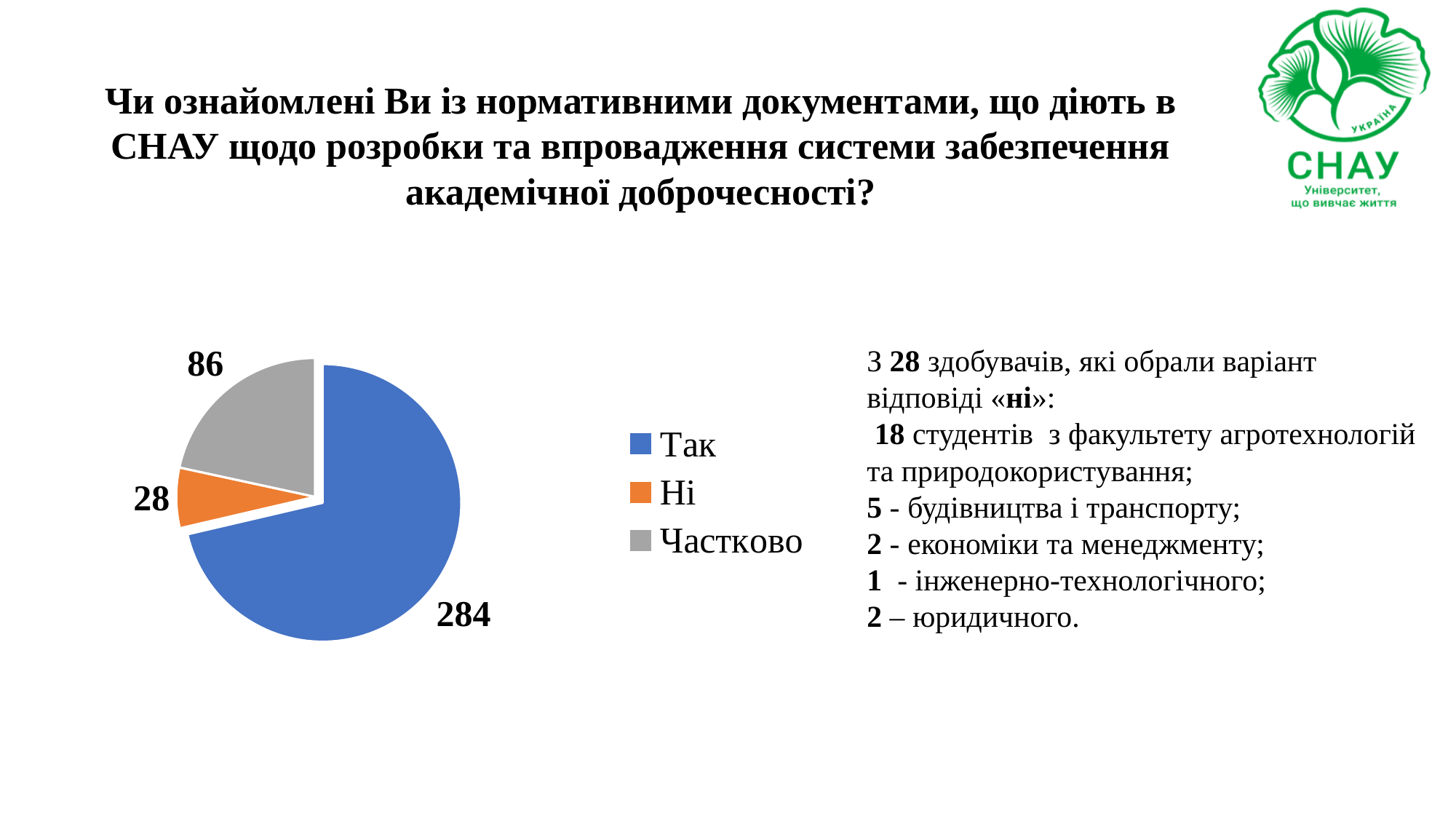
What value is shown for the "Частково" slice of the pie chart? 86 Which category has the smallest slice in the pie chart? Ні Which category has the largest slice in the pie chart? Так What is the difference between the values for "Так" and "Частково"? 198 What value is shown for the "Ні" slice of the pie chart? 28 What is the total of all values shown in the pie chart? 398 How many slices does the pie chart have? 3 What value is shown for the "Так" slice of the pie chart? 284 What type of chart is shown on the slide? Pie chart Which is larger, the value for "Частково" or the value for "Ні"? Частково What colour is the "Ні" slice in the pie chart? Orange What is the difference between the values for "Частково" and "Ні"? 58